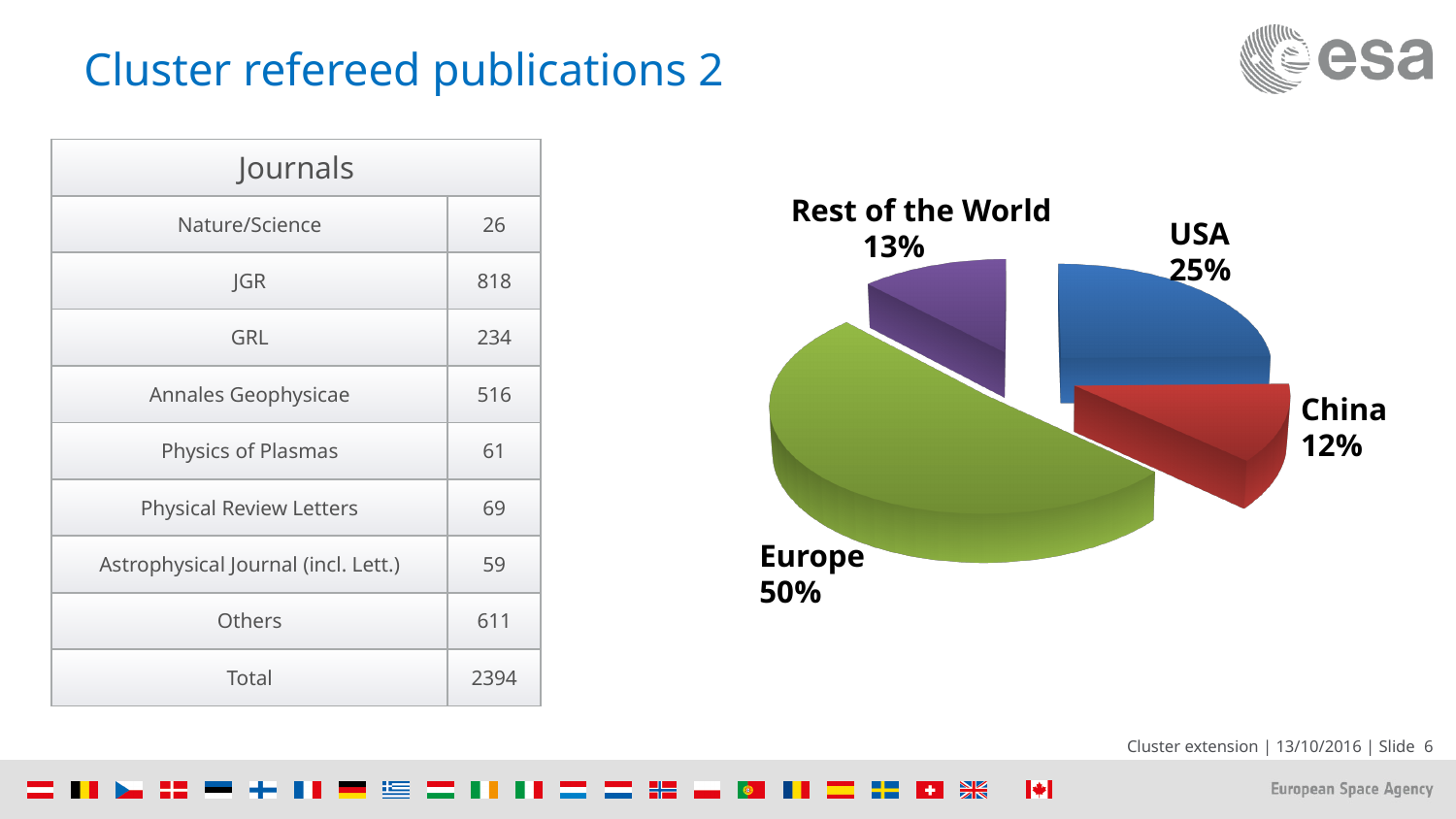
In the pie chart, what is the difference between the Rest of the World share and the China share? 1% What is the value shown for China in the pie chart? 12% What type of chart is shown on the right of the slide? Pie chart What is the value shown for Rest of the World in the pie chart? 13% In the pie chart, what is the difference between the Europe share and the USA share? 25% In the pie chart, which is larger: the USA share or the Rest of the World share? USA Which slice of the pie chart is the largest? Europe What is the value shown for USA in the pie chart? 25% How many slices does the pie chart have? 4 Which slice of the pie chart is the smallest? China What share of the pie chart does Europe account for? 50% What colour is the Europe slice in the pie chart? Green